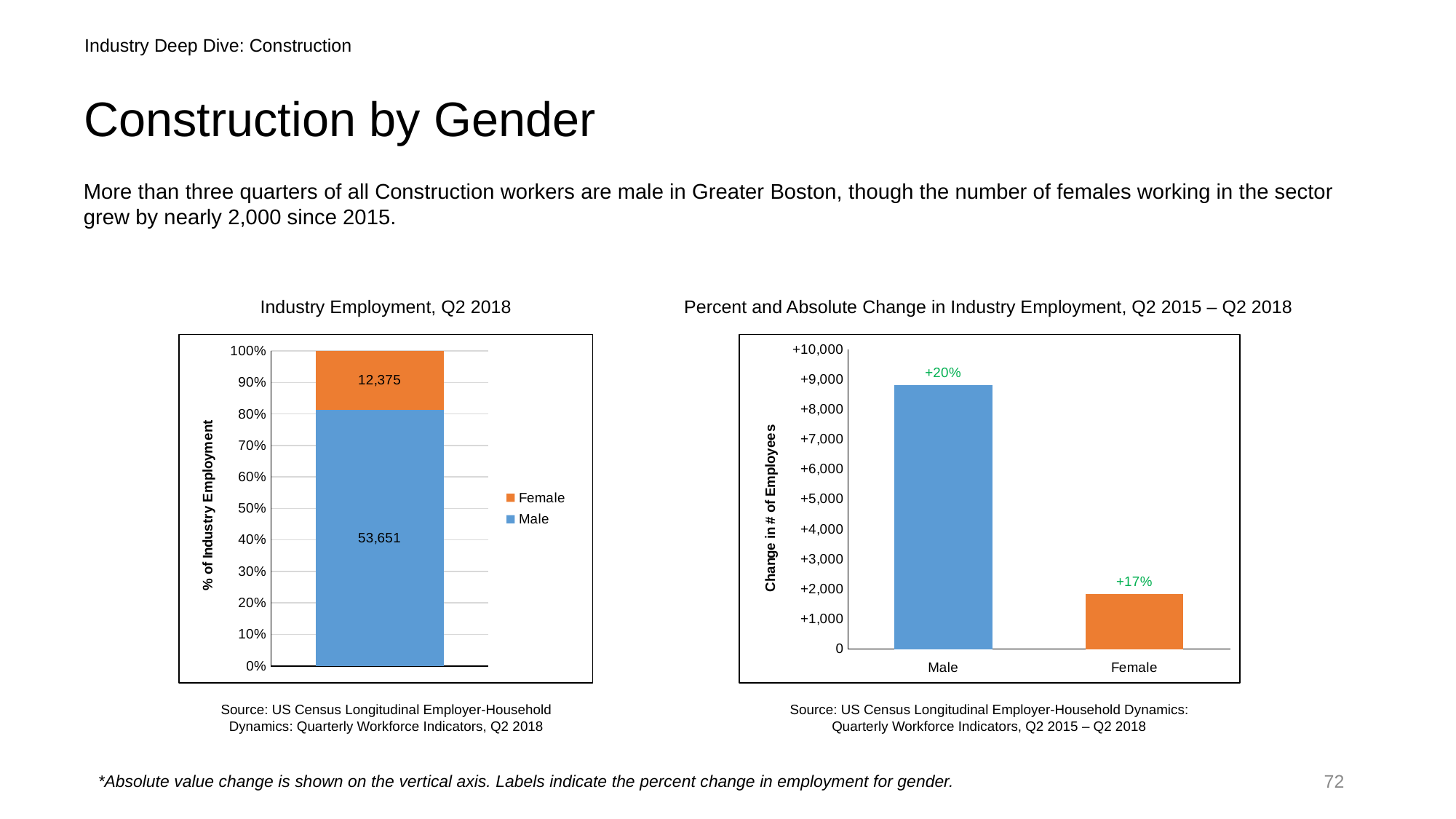
In the 'Percent and Absolute Change in Industry Employment, Q2 2015 – Q2 2018' chart, what percent change label is shown for Female? +17% In the 'Percent and Absolute Change in Industry Employment, Q2 2015 – Q2 2018' chart, which category has the larger absolute change in number of employees? Male In the 'Percent and Absolute Change in Industry Employment, Q2 2015 – Q2 2018' chart, is the change in number of employees for Female greater or less than +2,000? less In the 'Percent and Absolute Change in Industry Employment, Q2 2015 – Q2 2018' chart, what percent change label is shown for Male? +20% In the 'Industry Employment, Q2 2018' chart, how many Male employees are shown? 53,651 In the 'Industry Employment, Q2 2018' chart, how many Female employees are shown? 12,375 In the 'Industry Employment, Q2 2018' chart, how many series does the legend list? 2 In the 'Industry Employment, Q2 2018' chart, what is the difference between the Male and Female employee counts? 41,276 In the 'Industry Employment, Q2 2018' chart, what is the total of the stacked bar (Male plus Female)? 66,026 What type of chart is the 'Percent and Absolute Change in Industry Employment, Q2 2015 – Q2 2018' chart? Bar chart In the 'Percent and Absolute Change in Industry Employment, Q2 2015 – Q2 2018' chart, is the change in number of employees for Male greater or less than +8,000? greater In the 'Industry Employment, Q2 2018' chart, which colour represents Female? Orange